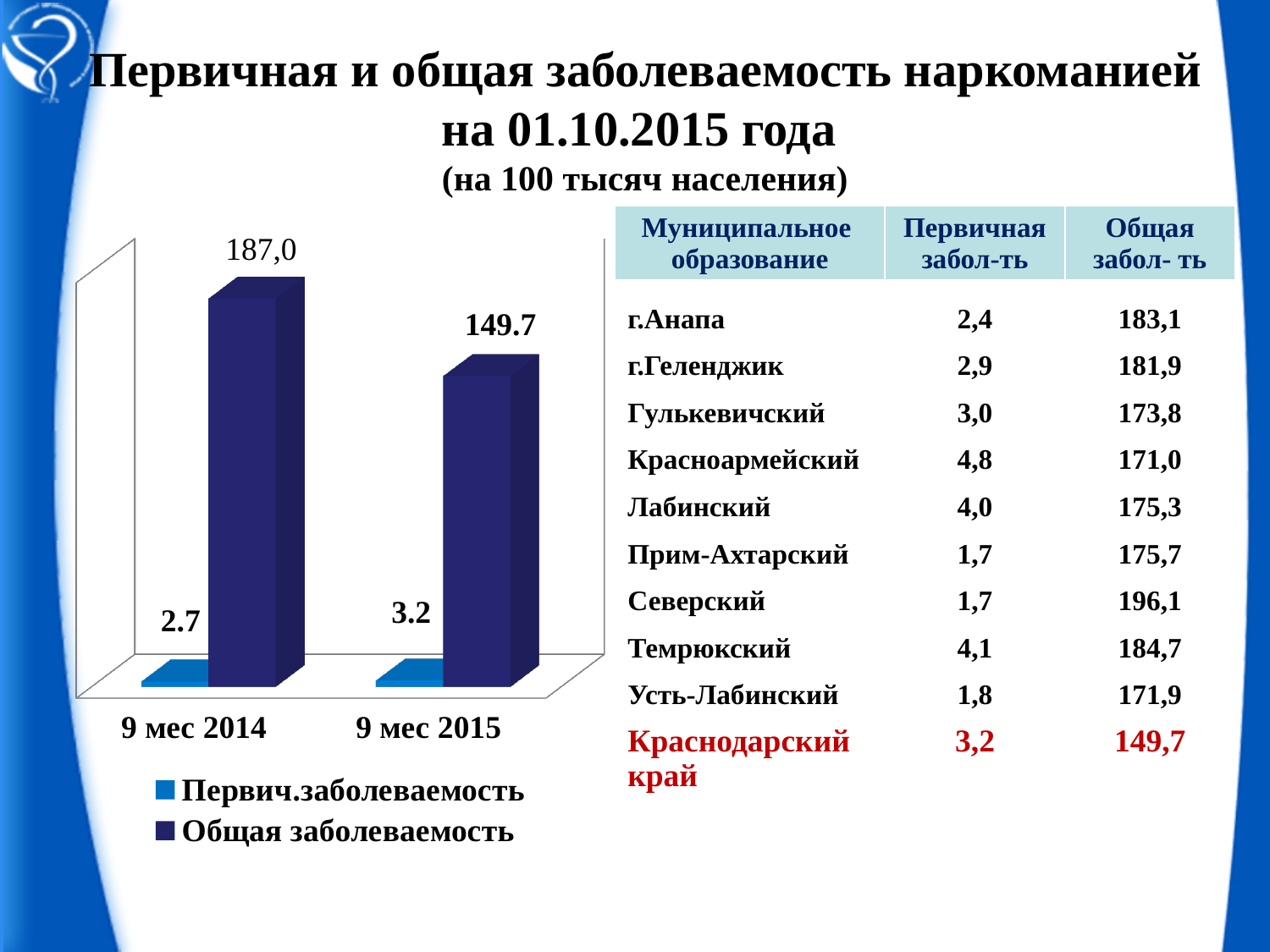
By how much did Общая заболеваемость decrease from 9 мес 2014 to 9 мес 2015? 37.3 Is Первич.заболеваемость larger in 9 мес 2014 or 9 мес 2015? 9 мес 2015 Which period has the higher Общая заболеваемость value? 9 мес 2014 What is the value of Общая заболеваемость for 9 мес 2015? 149.7 What type of chart is shown on the slide? Bar chart How many periods (categories) are shown on the x axis of the chart? 2 What is the value of Общая заболеваемость for 9 мес 2014? 187,0 Which period has the lower Первич.заболеваемость value? 9 мес 2014 What is the difference in Первич.заболеваемость between 9 мес 2015 and 9 мес 2014? 0.5 What is the value of Первич.заболеваемость for 9 мес 2014? 2.7 What is the value of Первич.заболеваемость for 9 мес 2015? 3.2 How many series does the chart legend list? 2